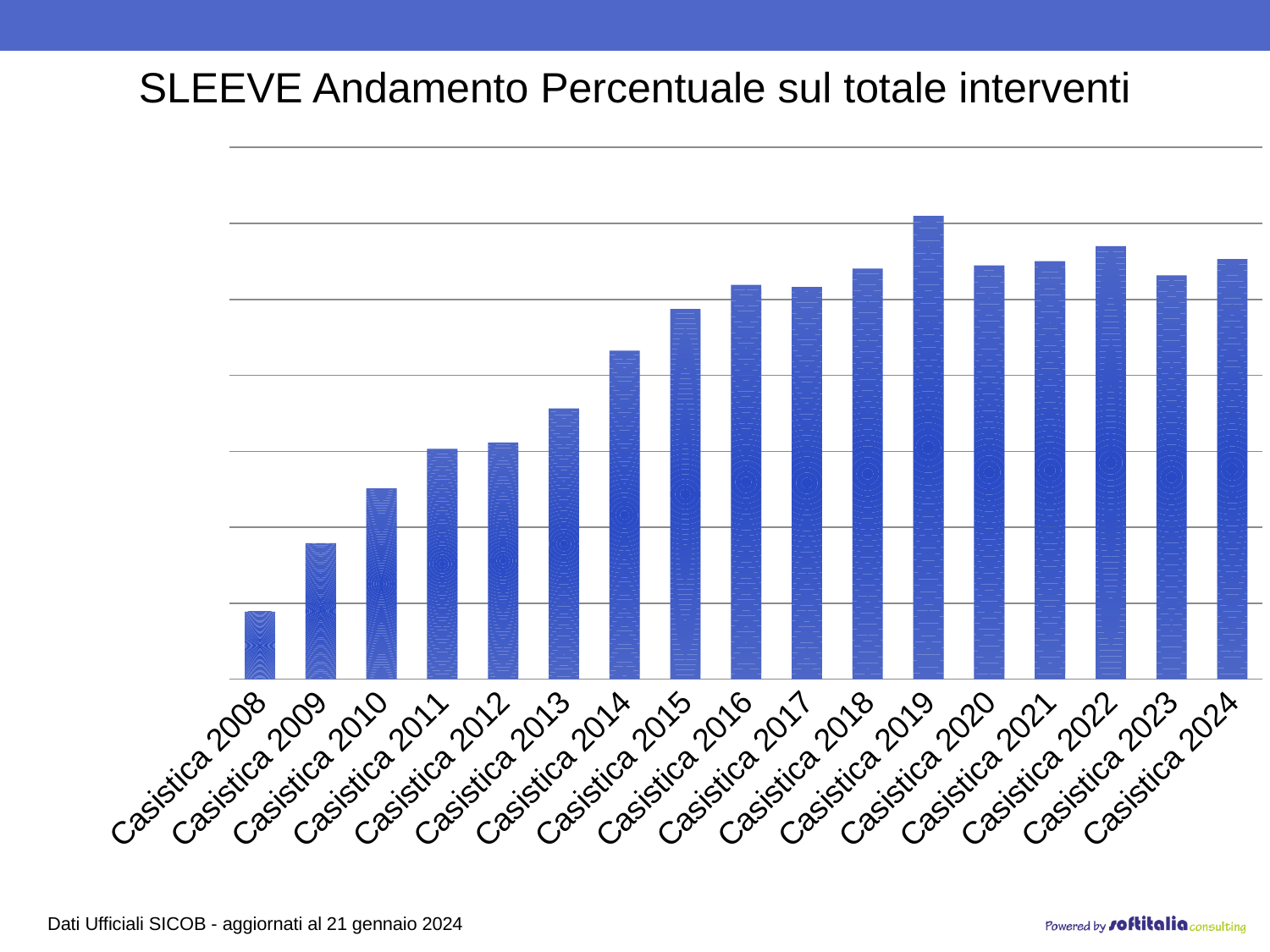
How many categories (bars) are plotted in the chart? 17 What colour are the bars in the chart? blue What kind of chart is shown on the slide? bar chart Which is larger, the value for Casistica 2023 or Casistica 2024? Casistica 2024 Which is larger, the value for Casistica 2019 or Casistica 2020? Casistica 2019 What is the title of the chart? SLEEVE Andamento Percentuale sul totale interventi Which is larger, the value for Casistica 2022 or Casistica 2023? Casistica 2022 Do the values generally rise or fall from Casistica 2008 to Casistica 2019? rise Which category has the highest value in the chart? Casistica 2019 Which category has the lowest value in the chart? Casistica 2008